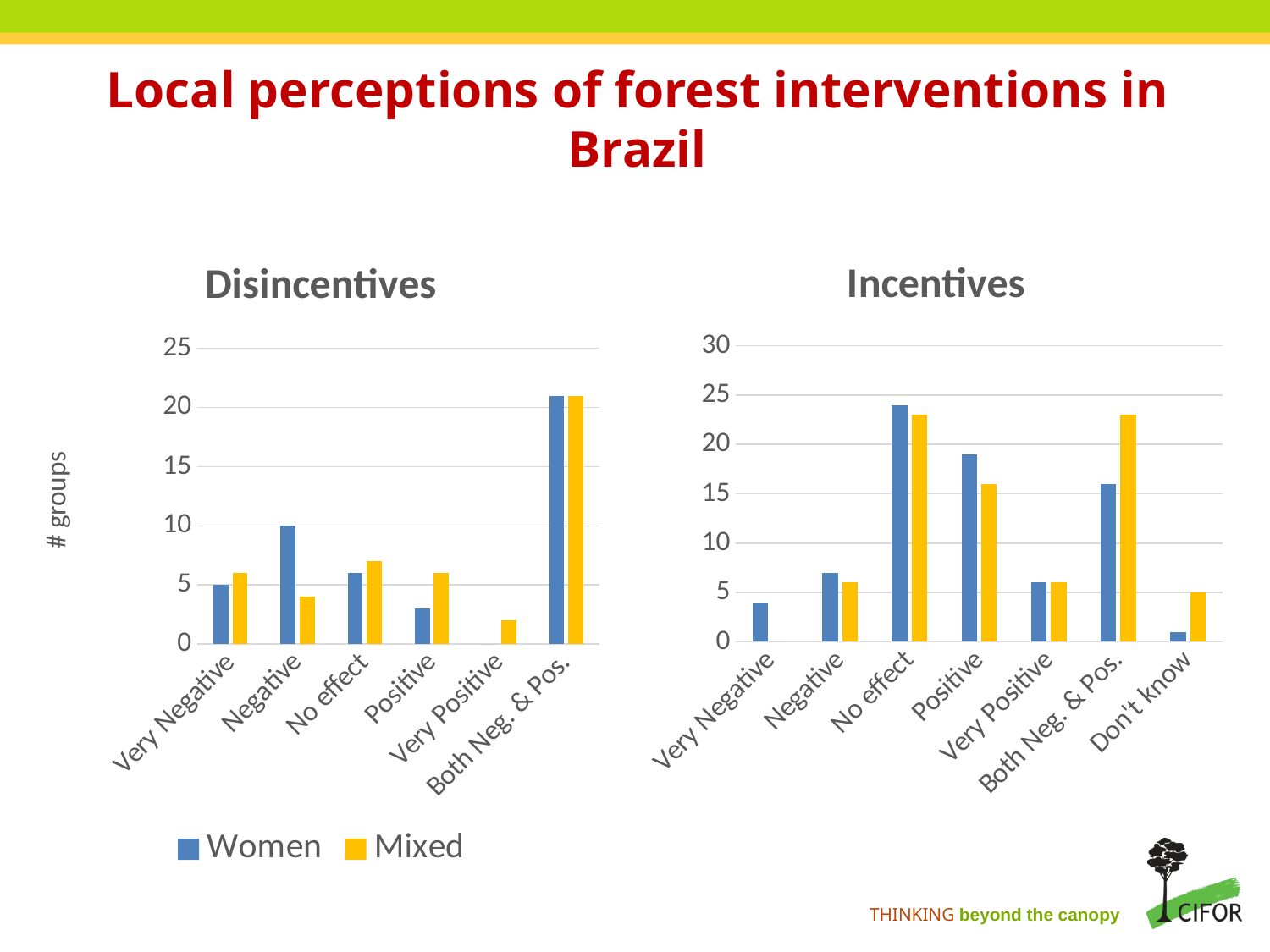
In the Incentives chart, which category has the highest value for Women? No effect In the Incentives chart, which is larger for Both Neg. & Pos.: Women or Mixed? Mixed In the Incentives chart, is the Mixed value for Both Neg. & Pos. greater or less than 20? greater How many categories are shown on the x axis of the Disincentives chart? 6 In the Disincentives chart, which is larger for Negative: Women or Mixed? Women In the Disincentives chart, is the Women value for Both Neg. & Pos. greater or less than 20? greater In the Disincentives chart, which category has the highest value for Women? Both Neg. & Pos. How many series does the legend list? 2 What kind of chart is the Disincentives chart? bar chart In the Incentives chart, which category has the lowest value for Women? Don't know What is the label on the vertical axis of the charts? # groups How many categories are shown on the x axis of the Incentives chart? 7